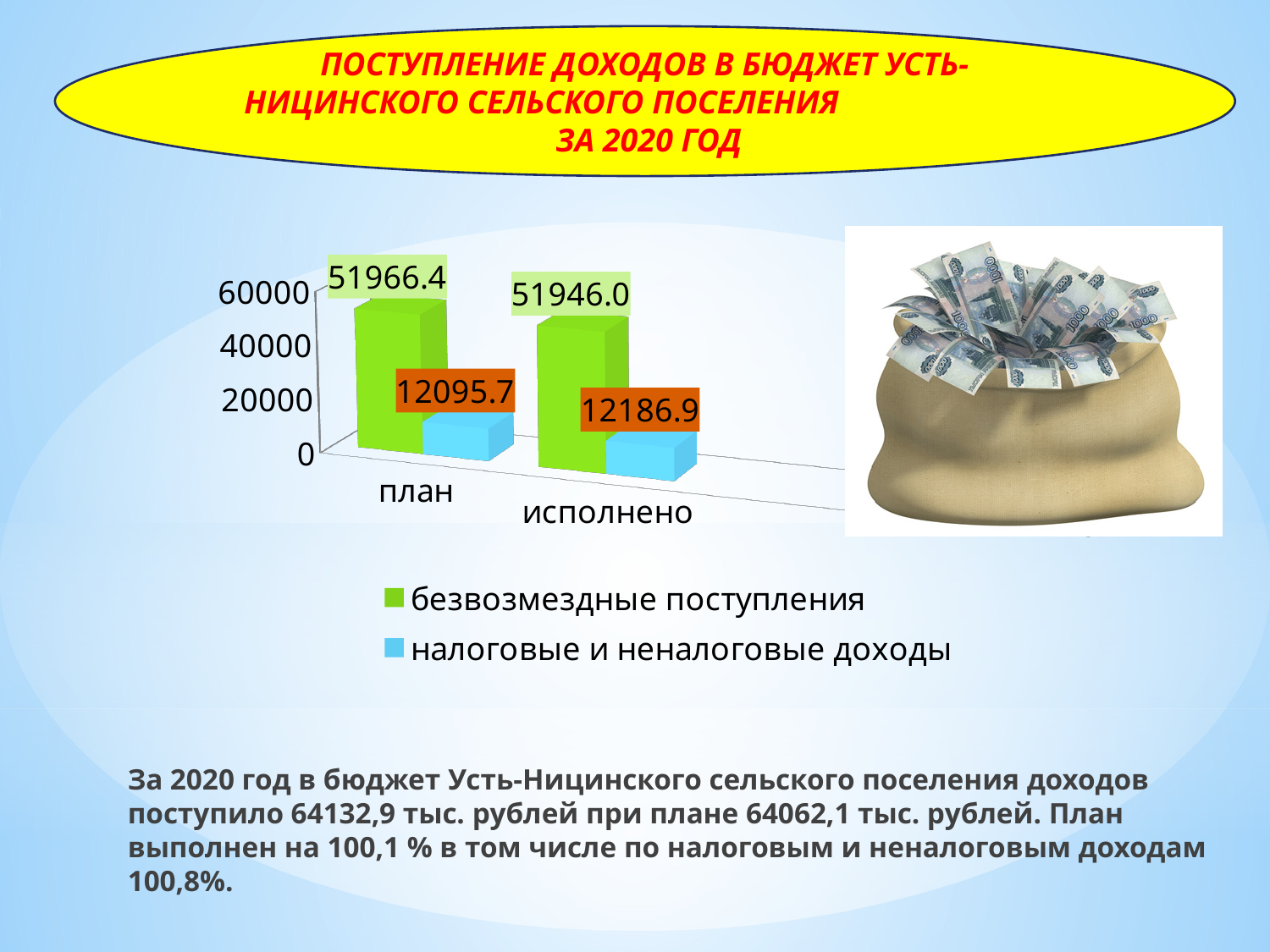
What kind of chart is shown on the slide? bar chart What is the difference between налоговые и неналоговые доходы for исполнено and for план? 91.2 Which colour represents налоговые и неналоговые доходы in the chart legend? blue What is the value of безвозмездные поступления for исполнено? 51946.0 Which series has the larger value for план: безвозмездные поступления or налоговые и неналоговые доходы? безвозмездные поступления Is the value of безвозмездные поступления for исполнено greater or less than 40000? greater What is the value of налоговые и неналоговые доходы for исполнено? 12186.9 What is the difference between безвозмездные поступления for план and for исполнено? 20.4 What is the value of налоговые и неналоговые доходы for план? 12095.7 What is the value of безвозмездные поступления for план? 51966.4 How many series does the chart legend list? 2 How many categories are shown on the x axis of the chart? 2